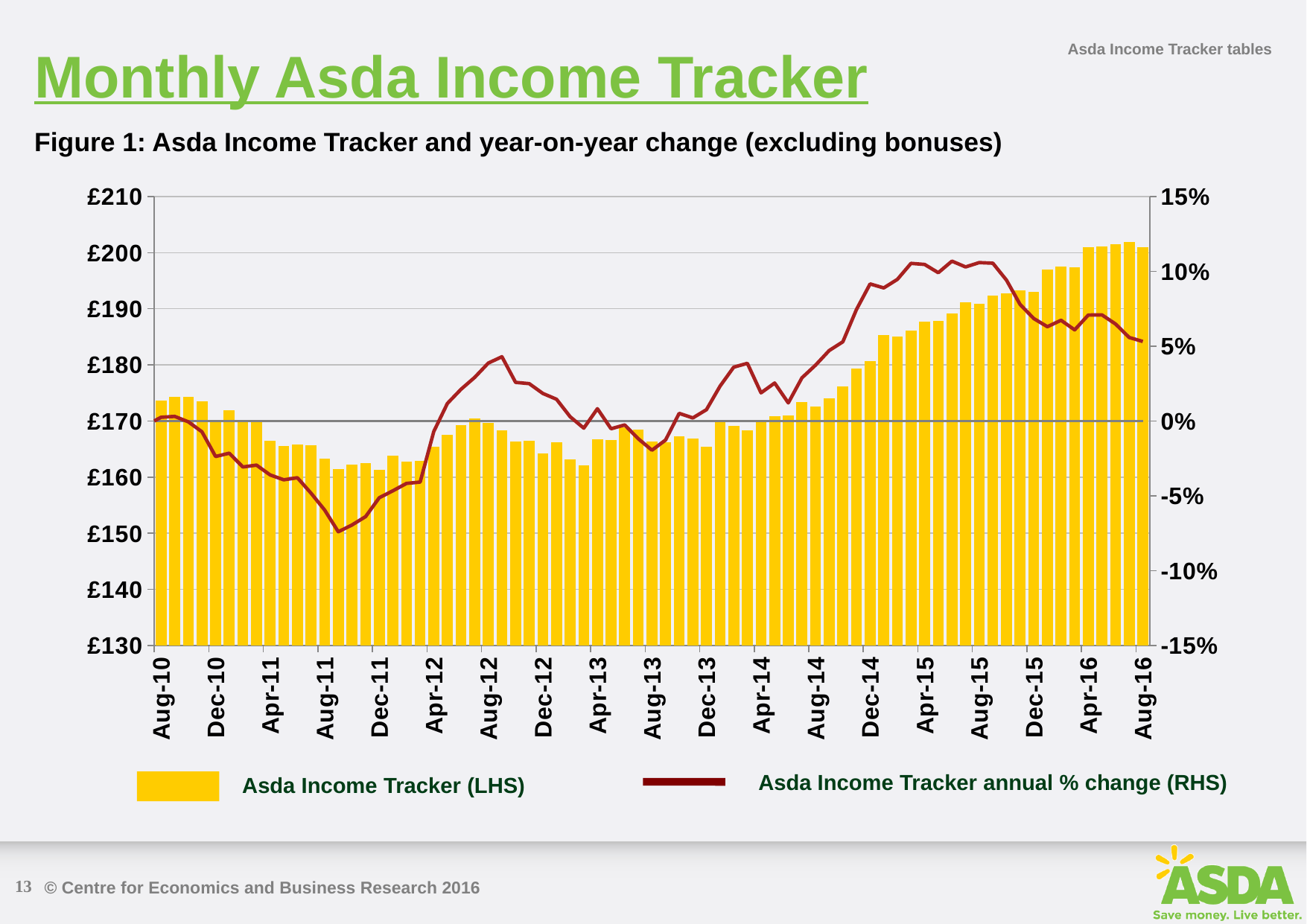
Is the annual % change line for Apr-15 greater or less than 5%? greater Which series is plotted as the dark red line? Asda Income Tracker annual % change (RHS) Do the Asda Income Tracker bars rise or fall from Aug-14 to Aug-16? rise Which series is plotted as yellow bars? Asda Income Tracker (LHS) How many series does the legend list? 2 Which is larger, the Asda Income Tracker bar for Aug-11 or for Aug-14? Aug-14 Is the Asda Income Tracker bar for Aug-10 greater or less than £170? greater What kind of chart is shown on the slide? A combined bar and line chart Is the Asda Income Tracker bar for Aug-11 greater or less than £170? less Which is larger, the Asda Income Tracker bar for Aug-10 or for Aug-16? Aug-16